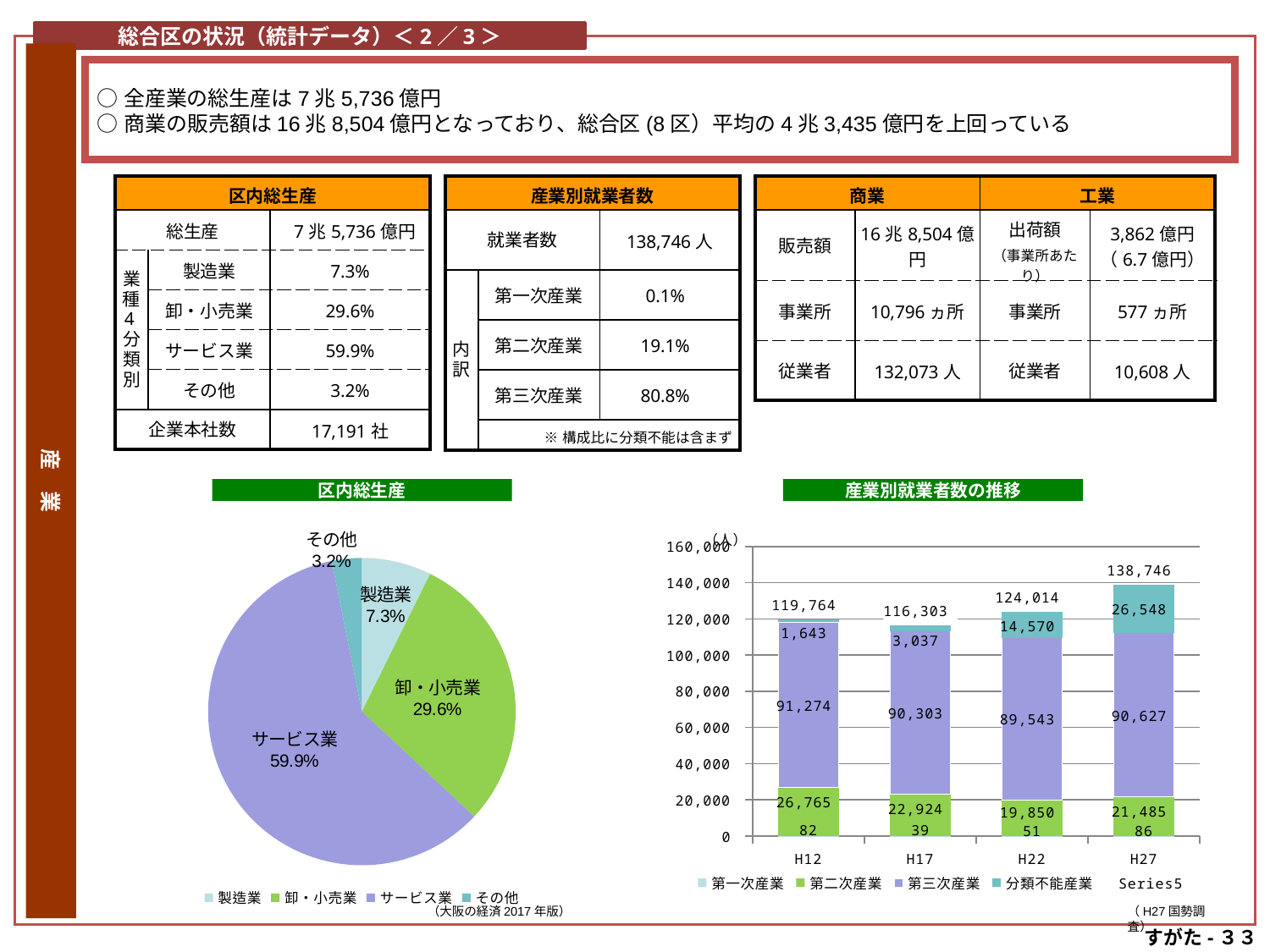
In the bar chart titled 産業別就業者数の推移, what is the value of 分類不能産業 for H22? 14,570 In the bar chart titled 産業別就業者数の推移, is the value of 第二次産業 for H12 larger or smaller than for H22? larger In the pie chart titled 区内総生産, which category has the largest share? サービス業 In the bar chart titled 産業別就業者数の推移, what is the total for H27? 138,746 In the pie chart titled 区内総生産, what share does サービス業 have? 59.9% In the pie chart titled 区内総生産, what is the difference between the shares of 卸・小売業 and 製造業? 22.3% In the pie chart titled 区内総生産, how many slices are there? 4 In the pie chart titled 区内総生産, which category has the smallest share? その他 What kind of chart is the one titled 産業別就業者数の推移? stacked bar chart In the bar chart titled 産業別就業者数の推移, which year has the lowest total? H17 In the bar chart titled 産業別就業者数の推移, what is the value of 第三次産業 for H12? 91,274 In the bar chart titled 産業別就業者数の推移, how many series does the legend list? 5